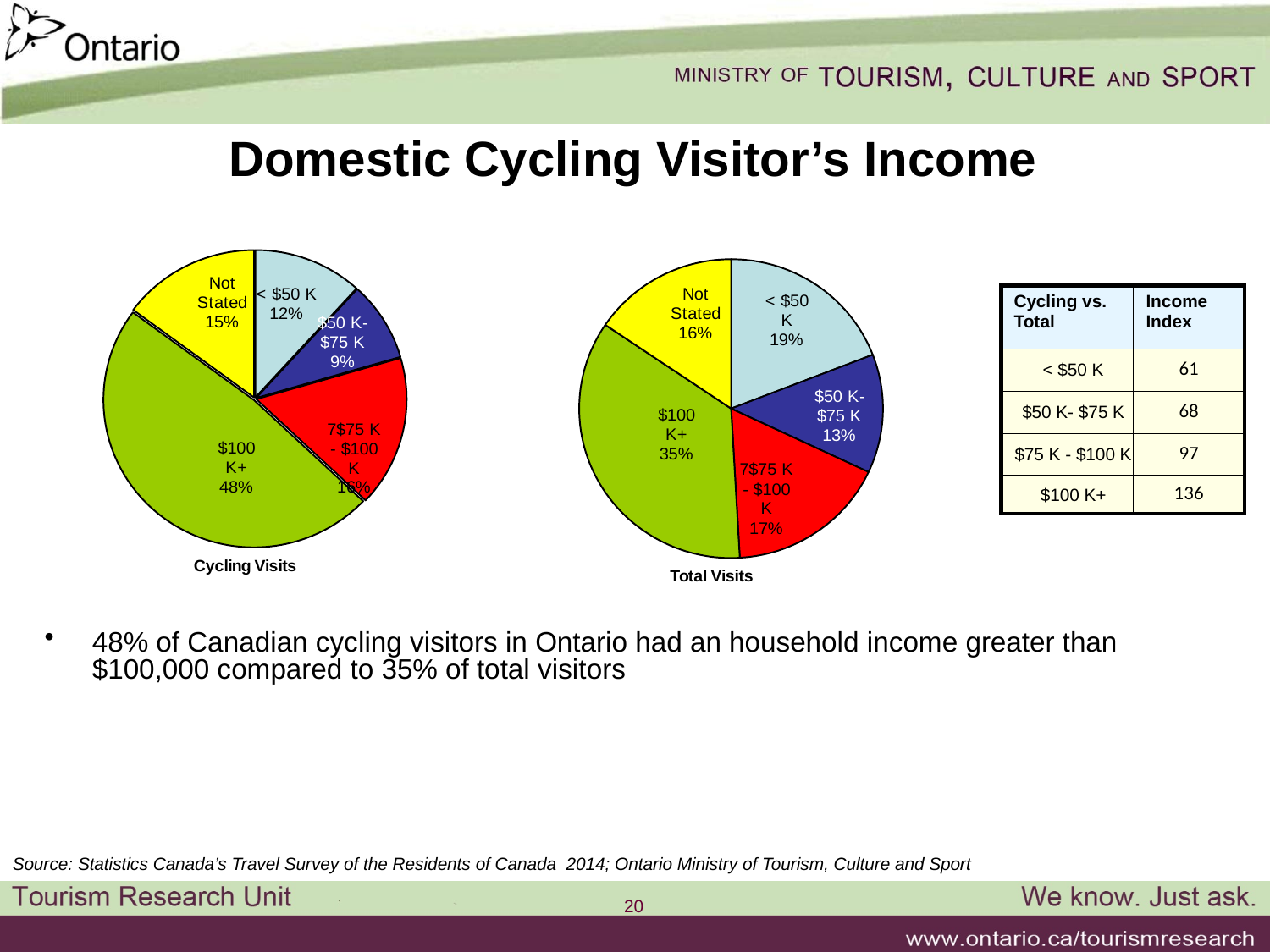
In the Cycling Visits pie chart, what share of visitors had a household income of $100 K+? 48% In the Total Visits pie chart, what percentage is shown for the Not Stated slice? 16% In the Cycling Visits pie chart, which income category has the largest slice? $100 K+ In the Total Visits pie chart, what percentage is shown for the $50 K- $75 K slice? 13% In the Total Visits pie chart, what share of visitors had a household income of $100 K+? 35% In the Cycling Visits pie chart, what percentage is shown for the < $50 K slice? 12% What type of chart is used for Cycling Visits? Pie chart In the Total Visits pie chart, which income category has the smallest slice? $50 K- $75 K Which chart shows a larger share for < $50 K, Cycling Visits or Total Visits? Total Visits What is the difference between the $100 K+ share in the Cycling Visits chart and the $100 K+ share in the Total Visits chart? 13% How many slices does the Total Visits pie chart have? 5 In the Cycling Visits pie chart, which income category has the smallest slice? $50 K- $75 K